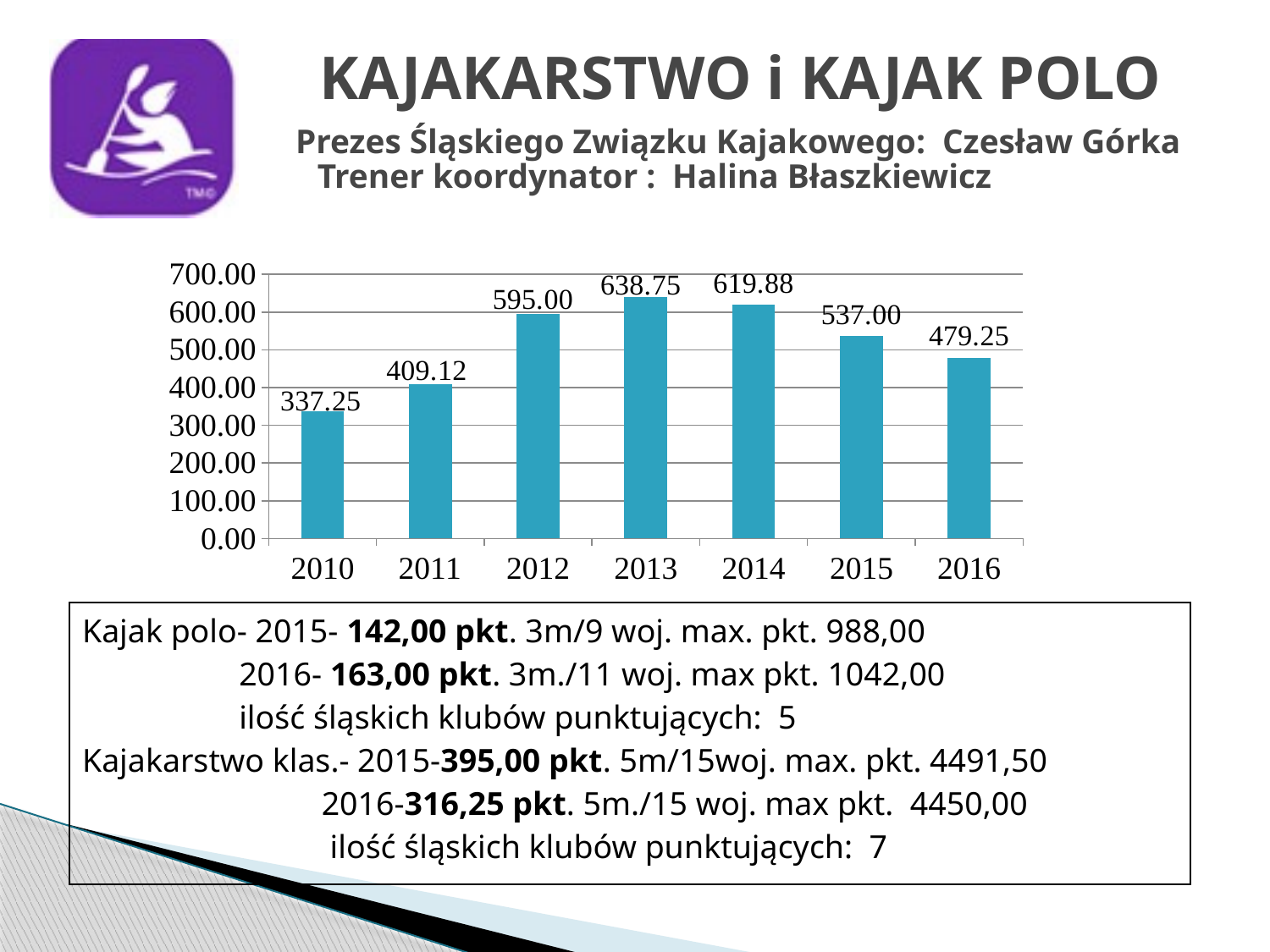
Do the values rise or fall from 2013 to 2016? fall What is the value for 2016? 479.25 Which year has the highest value? 2013 What is the difference between the values for 2013 and 2014? 18.87 Which is larger, the value for 2012 or the value for 2015? 2012 What is the value for 2010? 337.25 How many years are shown on the x axis? 7 What kind of chart is shown on the slide? bar chart What is the value for 2013? 638.75 What is the difference between the values for 2015 and 2016? 57.75 Which year has the lowest value? 2010 Is the value for 2011 greater or less than 400.00? greater